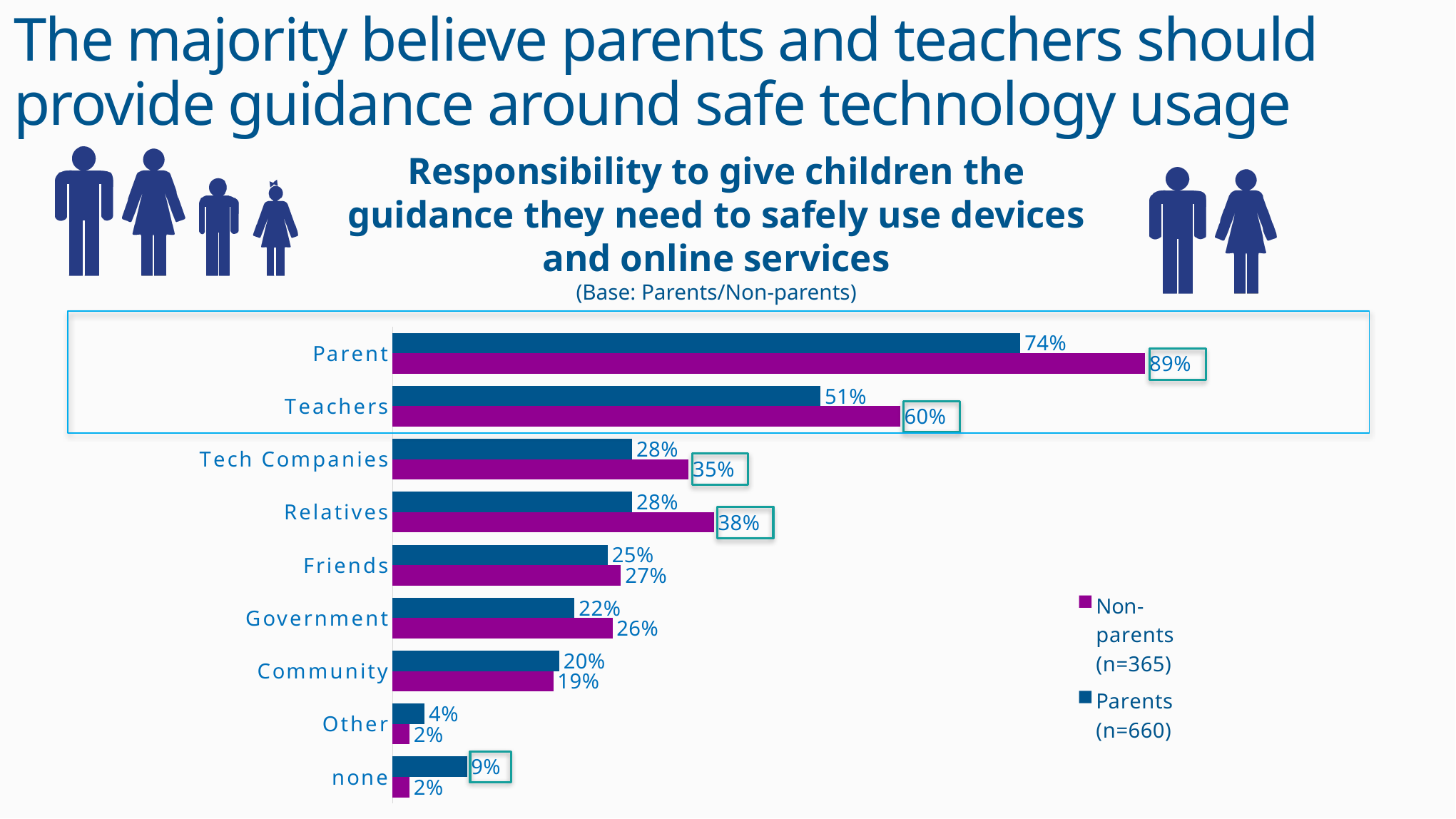
What percentage of Non-parents say Teachers are responsible? 60% What is the value for Government among Parents? 22% What kind of chart is shown on the slide? Bar chart How many series does the legend list? 2 How many categories are shown on the chart? 9 What is the value for Tech Companies among Non-parents? 35% What is the difference between Non-parents and Parents for the Parent category? 15% Which category has the highest value for Non-parents? Parent What percentage of Parents say Parent is responsible for giving children guidance on safe device use? 74% Which category has the lowest value for Parents? Other Which is larger for Community: the Parents value or the Non-parents value? Parents What is the sample size for the Parents series shown in the legend? n=660